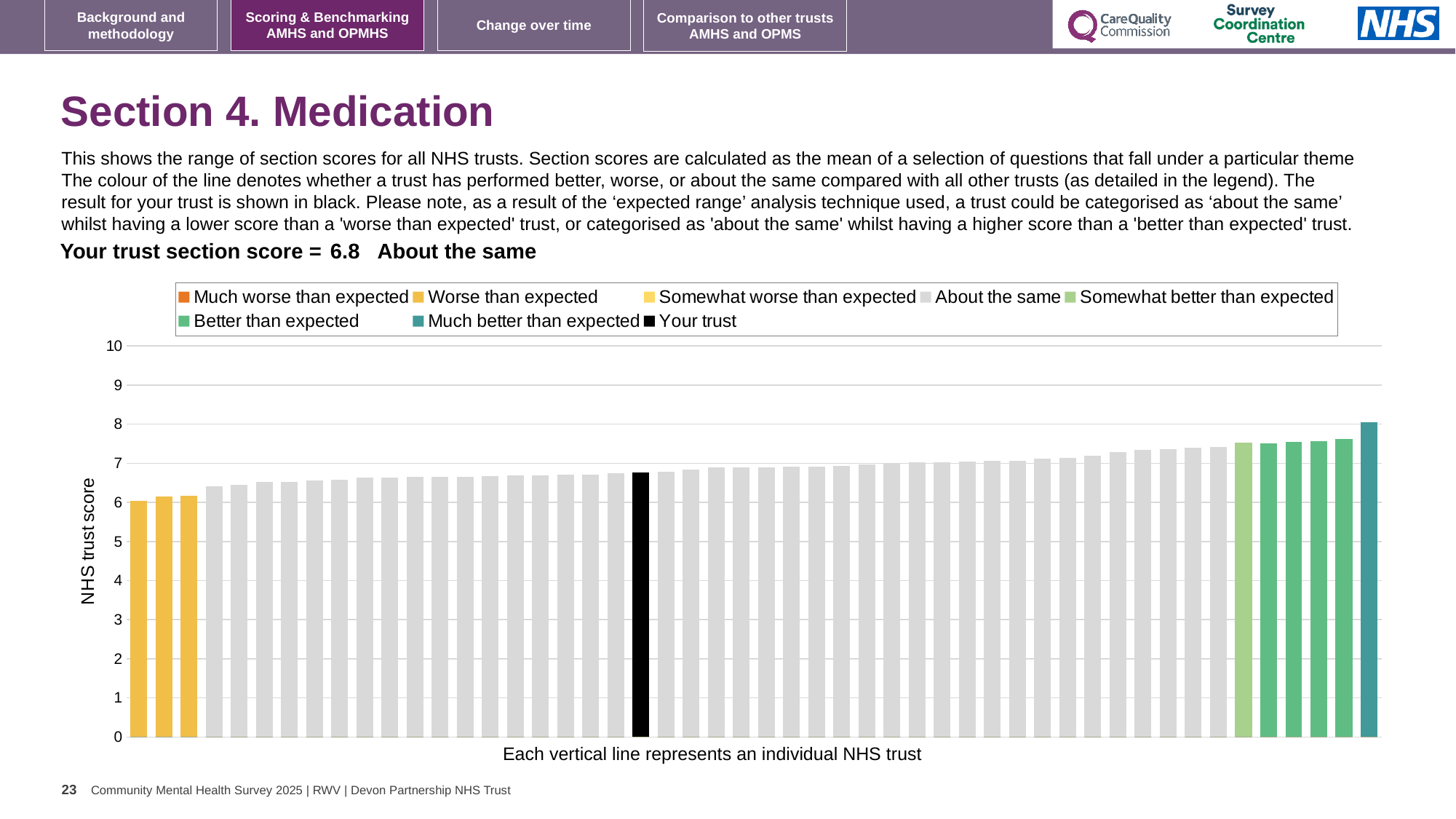
Which legend category does the tallest bar belong to? Much better than expected Do the bar values rise or fall from left to right along the x axis? rise Is the value of the leftmost bar greater or less than 5? greater How many entries does the chart legend list? 8 What colour is the bar representing your trust? black How many bars are coloured as 'Worse than expected' (yellow)? 3 How many bars are coloured as 'Much better than expected' (teal)? 1 What kind of chart is shown on the slide? bar chart What is the label on the vertical axis of the chart? NHS trust score What is the section score for your trust shown on the slide? 6.8 Is the value of the leftmost (lowest) bar greater or less than 7? less Is the value of the black 'Your trust' bar greater or less than 5? greater